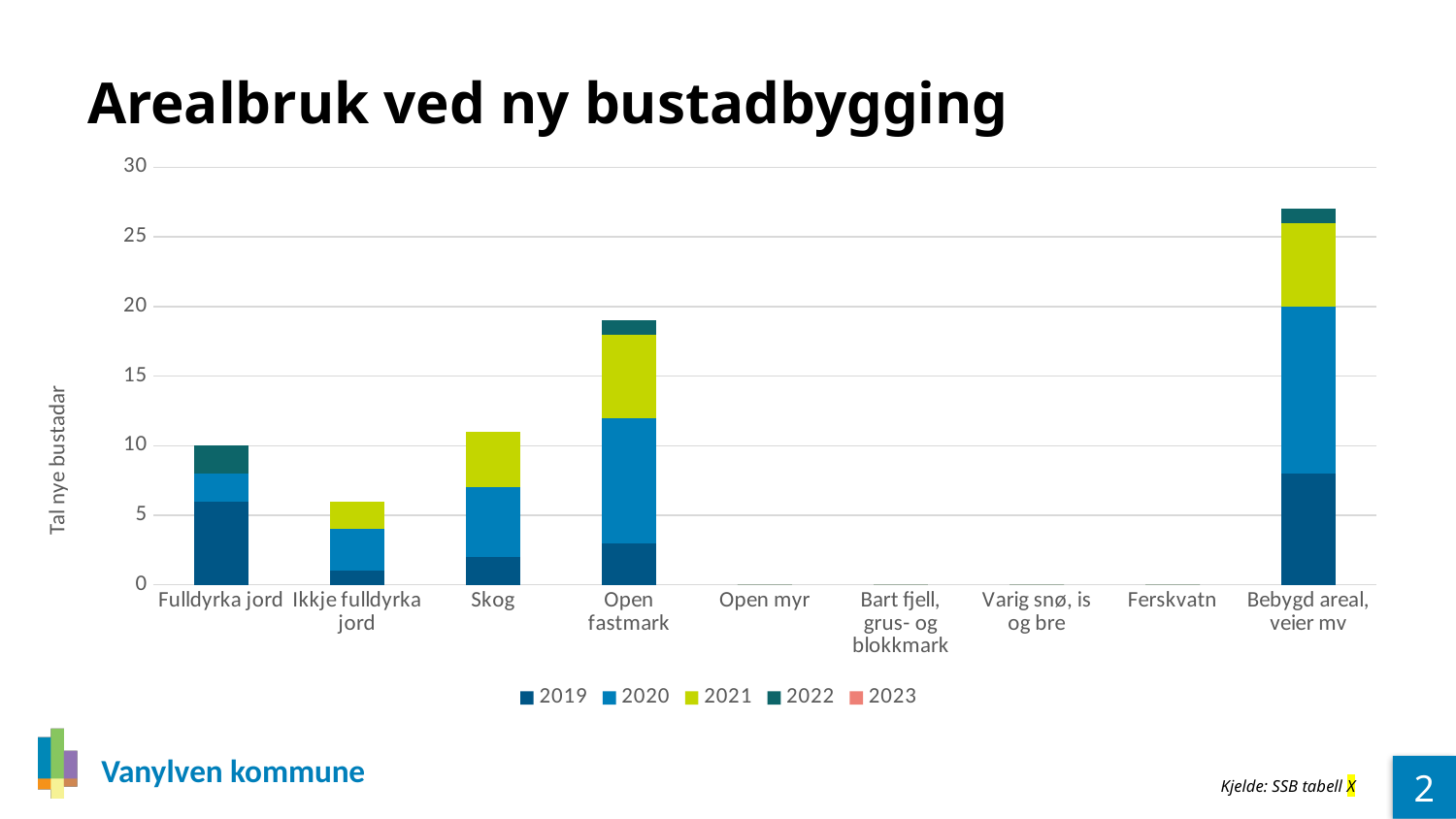
Is the total for Bebygd areal, veier mv greater or less than 25? greater What is the title of the chart? Arealbruk ved ny bustadbygging Which has the taller stacked bar, Bebygd areal, veier mv or Open fastmark? Bebygd areal, veier mv Is the total for Open fastmark greater or less than 15? greater How many categories are shown on the x axis of the chart? 9 Which has the taller stacked bar, Open fastmark or Skog? Open fastmark Which category has the tallest stacked bar? Bebygd areal, veier mv What is the label on the y axis of the chart? Tal nye bustadar How many series does the chart's legend list? 5 Is the total for Ikkje fulldyrka jord greater or less than 10? less What kind of chart is shown on the slide? stacked bar chart